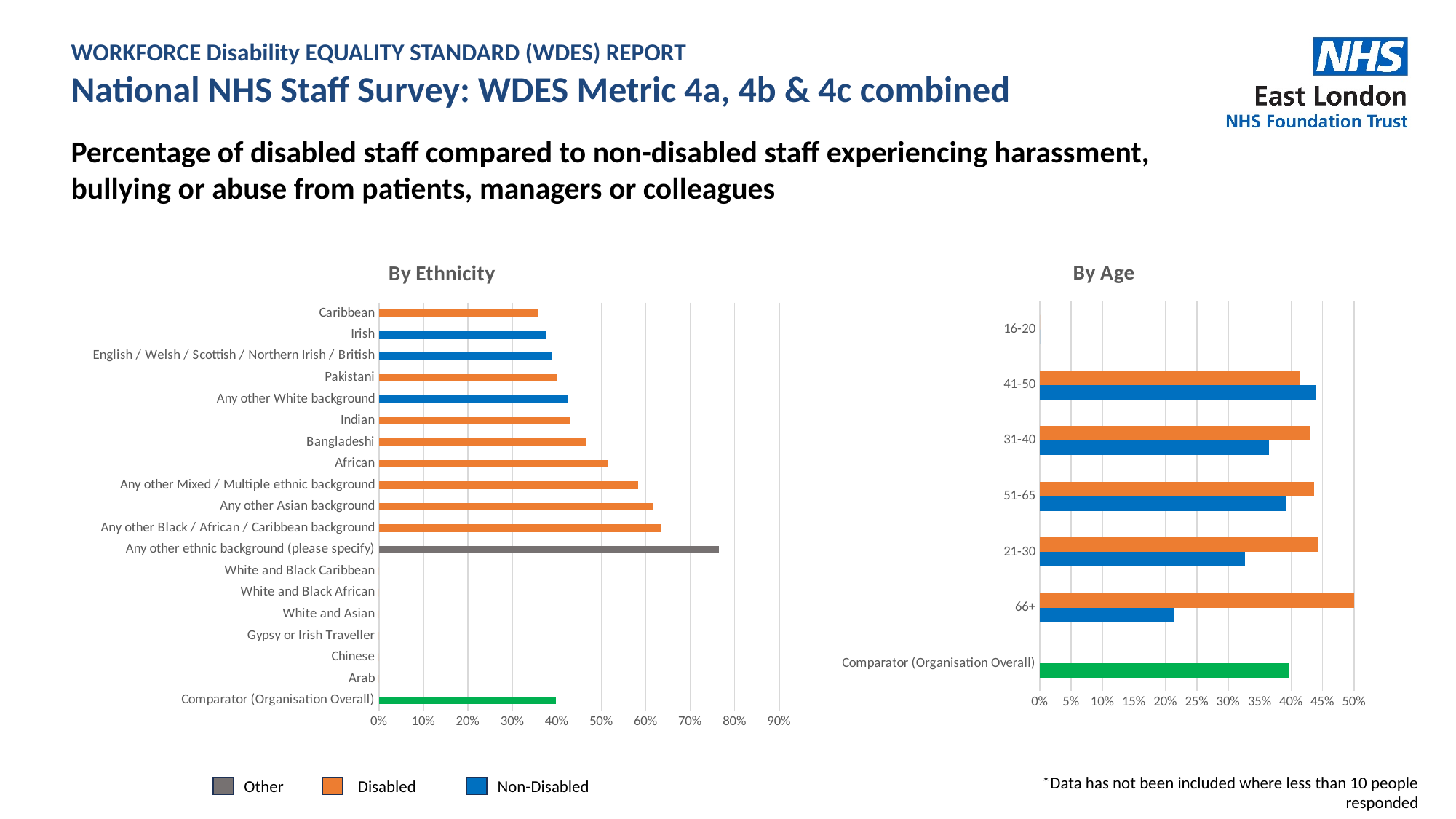
In the 'By Age' chart, is the Non-Disabled value for 66+ greater or less than 25%? less In the 'By Age' chart, which age group has the highest Disabled value? 66+ In the 'By Ethnicity' chart, which category has the longest bar? Any other ethnic background (please specify) In the 'By Age' chart, for the 21-30 group, which is larger, the Disabled or the Non-Disabled value? Disabled How many categories are listed on the y axis of the 'By Age' chart? 7 How many series does the legend list? 3 What kind of chart is the 'By Ethnicity' chart? bar chart In the 'By Age' chart, for the 41-50 group, which is larger, the Disabled or the Non-Disabled value? Non-Disabled In the 'By Age' chart, is the Non-Disabled value for 31-40 greater or less than 40%? less In the 'By Ethnicity' chart, is the value for Any other Black / African / Caribbean background greater or less than 60%? greater In the 'By Ethnicity' chart, which is larger, the value for Bangladeshi or the value for Indian? Bangladeshi